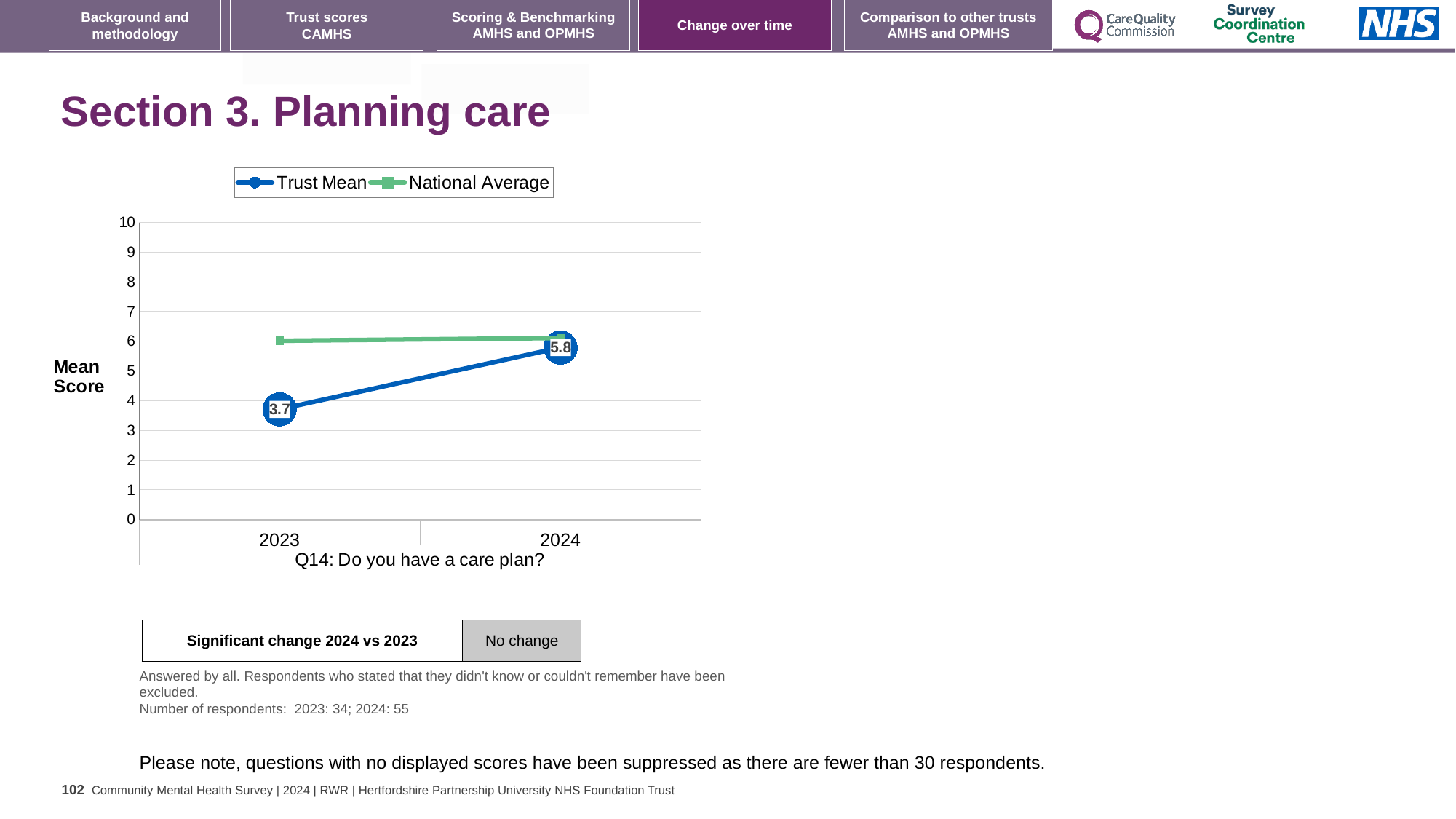
What is the label of the y axis? Mean Score How many series does the legend list? 2 What kind of chart is shown on the slide? line chart In 2023, which is higher: the Trust Mean or the National Average? National Average Is the National Average value for 2023 greater or less than 5? greater Is the National Average value for 2024 greater or less than 7? less What is the Trust Mean score for 2024? 5.8 By how much did the Trust Mean change from 2023 to 2024? 2.1 What is the Trust Mean score for 2023? 3.7 Does the Trust Mean rise or fall from 2023 to 2024? rise Which year has the higher Trust Mean score, 2023 or 2024? 2024 How many years are shown on the x axis? 2